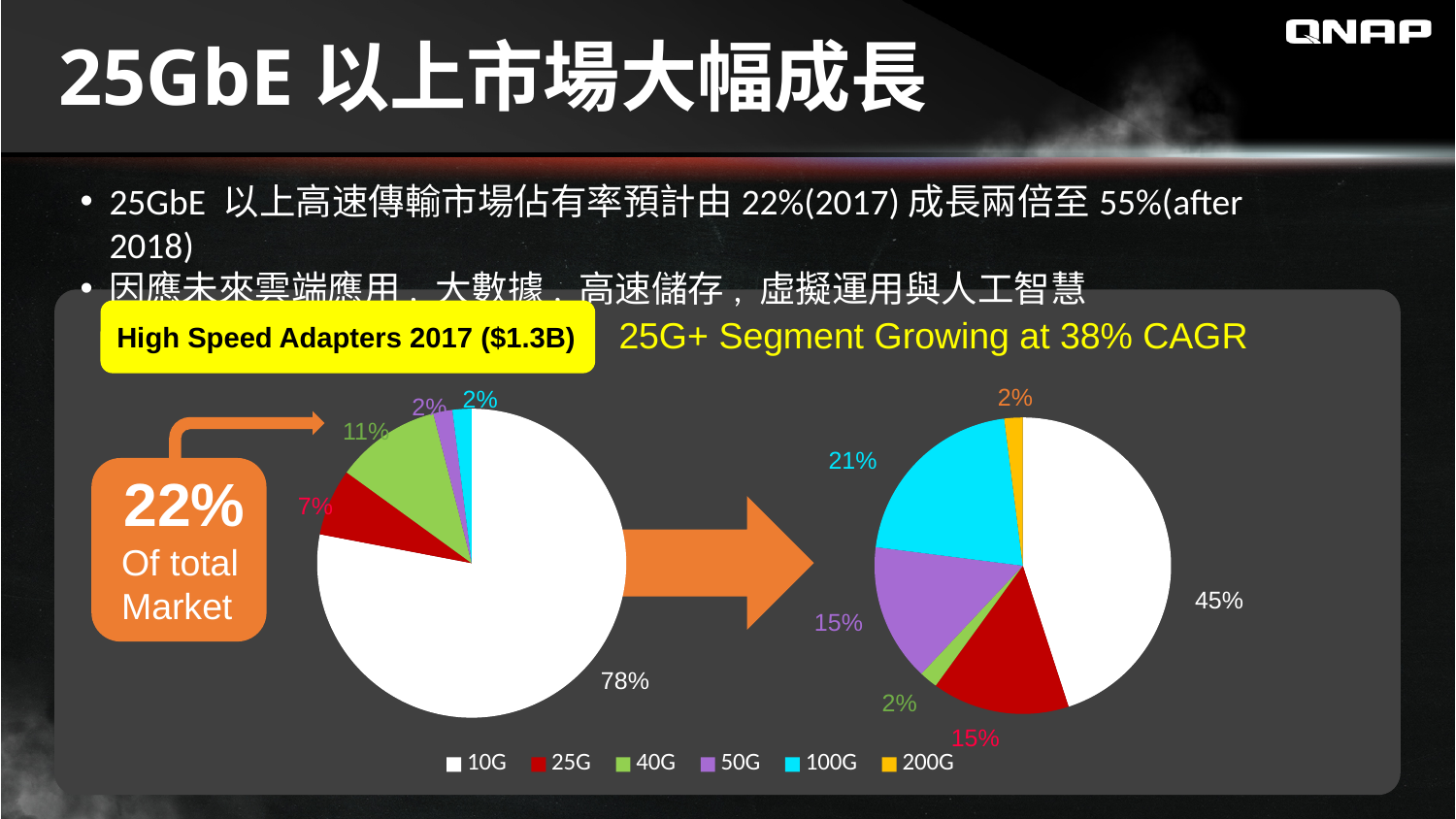
In the left pie chart (High Speed Adapters 2017), which category has the largest share? 10G What is the title shown above the right pie chart? 25G+ Segment Growing at 38% CAGR How many series does the legend list? 6 In the left pie chart (High Speed Adapters 2017), what share does 40G have? 11% In the right pie chart (25G+ Segment Growing at 38% CAGR), what share does 10G have? 45% In the right pie chart (25G+ Segment Growing at 38% CAGR), what is the difference between the 10G share and the 100G share? 24% In the right pie chart (25G+ Segment Growing at 38% CAGR), what share does 100G have? 21% What kind of charts are shown on the slide? Pie charts In the left pie chart (High Speed Adapters 2017), which is larger, the 40G share or the 25G share? 40G In the right pie chart (25G+ Segment Growing at 38% CAGR), which category has the largest share? 10G In the left pie chart (High Speed Adapters 2017), what share does 25G have? 7% In the left pie chart (High Speed Adapters 2017), what share does 10G have? 78%